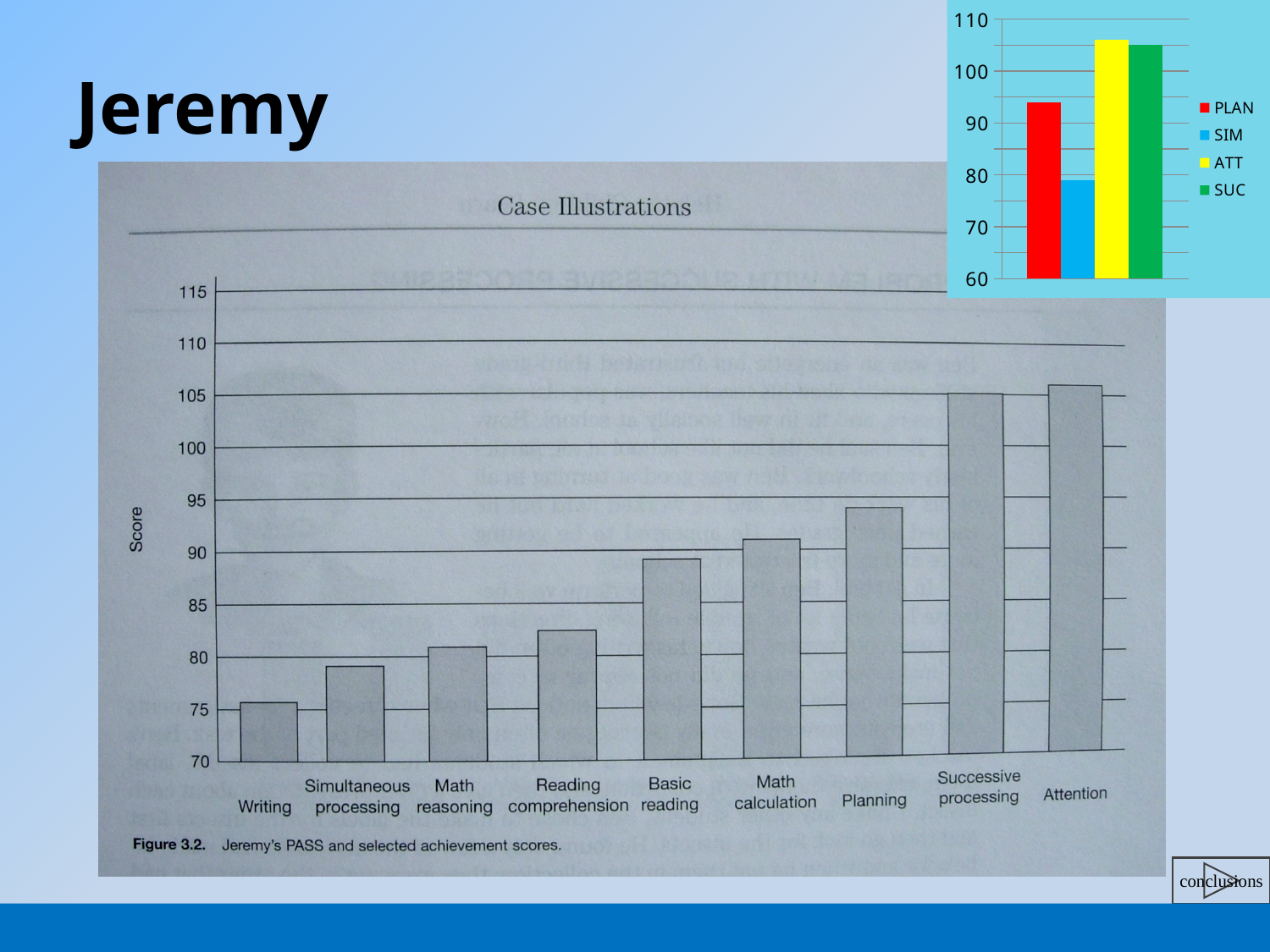
In the large chart titled Figure 3.2, is the score for Successive processing greater or less than 100? greater In the large chart titled Figure 3.2, what is the label on the y axis? Score In the large chart titled Figure 3.2, is the score for Writing greater or less than 80? less In the large chart titled Figure 3.2, what kind of chart is shown? bar chart In the small chart at the top right, which series has the lowest value? SIM In the large chart titled Figure 3.2, how many categories are plotted along the x axis? 9 In the small chart at the top right, is the value for PLAN greater or less than 90? greater In the small chart at the top right, how many series does the legend list? 4 In the large chart titled Figure 3.2, which category has the lowest score? Writing In the large chart titled Figure 3.2, do the scores generally rise or fall from left to right along the x axis? rise In the large chart titled Figure 3.2, which has the higher score, Planning or Math reasoning? Planning